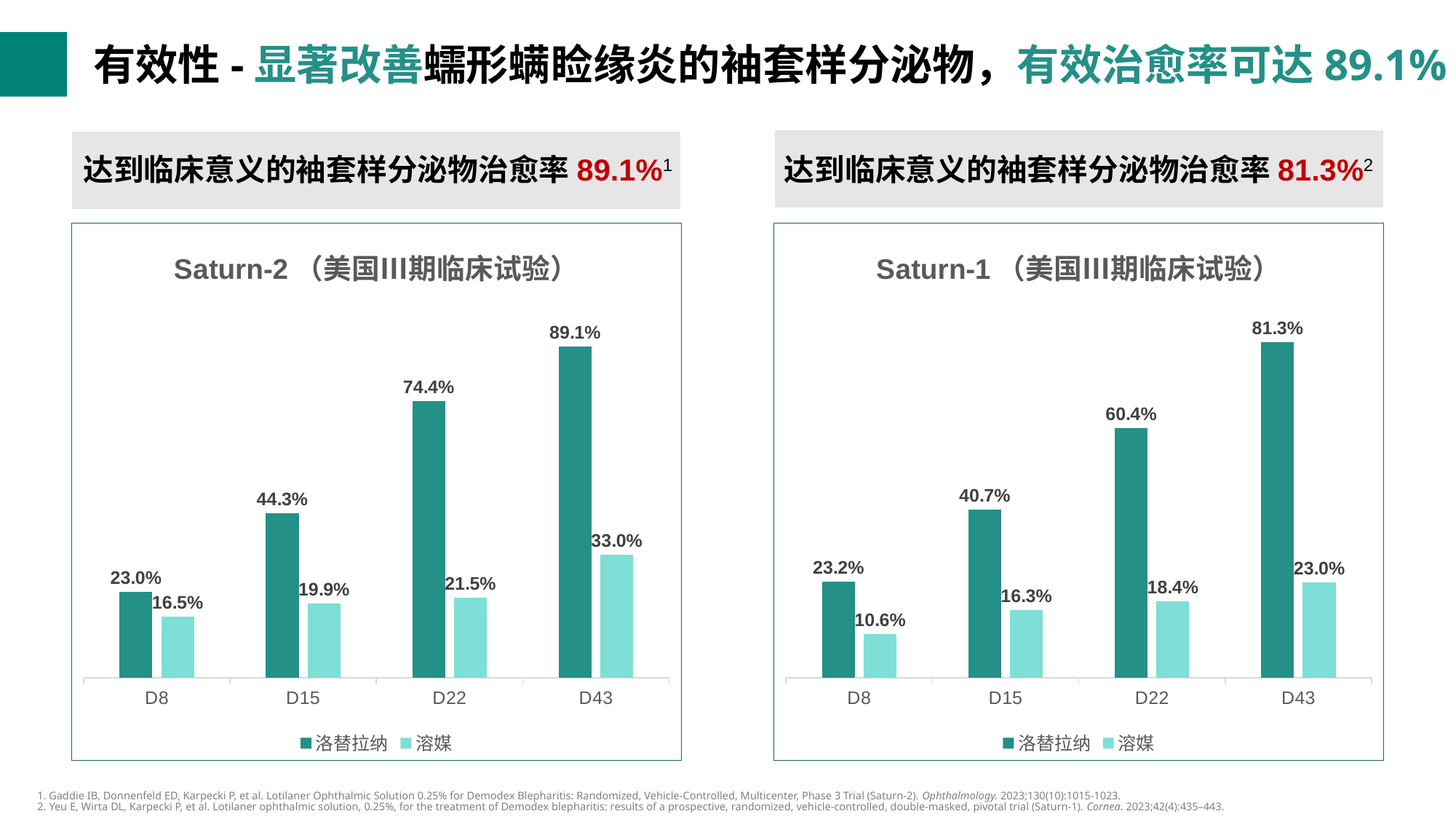
In the Saturn-2 chart, what is the value for 洛替拉纳 at D22? 74.4% In the Saturn-1 chart, which is larger at D15: the 洛替拉纳 value or the 溶媒 value? 洛替拉纳 In the Saturn-1 chart, do the 洛替拉纳 values rise or fall from D8 to D43? Rise In the Saturn-1 chart, what is the difference between the 洛替拉纳 values at D43 and D22? 20.9% What kind of chart is the Saturn-2 chart? Bar chart How many time points are shown on the x axis of the Saturn-2 chart? 4 How many series does the legend of the Saturn-1 chart list? 2 In the Saturn-2 chart, what is the value for 溶媒 at D43? 33.0% In the Saturn-2 chart, at which time point is the 溶媒 value lowest? D8 In the Saturn-1 chart, at which time point is the 洛替拉纳 value highest? D43 In the Saturn-1 chart, what is the value for 溶媒 at D8? 10.6% In the Saturn-2 chart, what is the difference between the 洛替拉纳 and 溶媒 values at D43? 56.1%